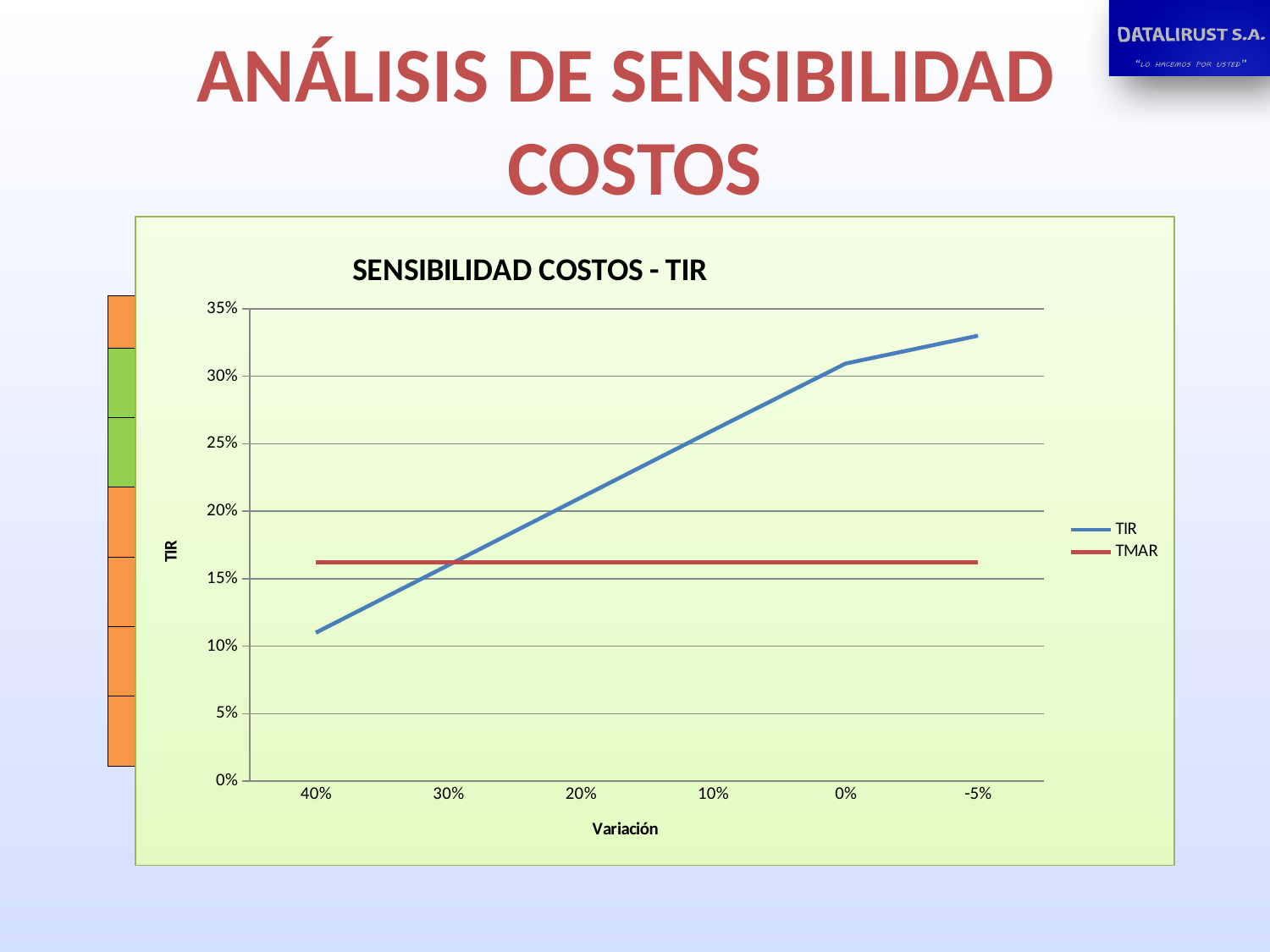
Is the TIR value at Variación 40% greater or less than 15%? less At which Variación value is TIR highest? -5% At which Variación value is TIR lowest? 40% How many categories are shown on the x axis (Variación)? 6 Does the TIR line rise or fall as you move from 40% to -5% along the x axis? rise At Variación 10%, which is larger, TIR or TMAR? TIR How many series does the legend of the chart list? 2 What are the two series named in the legend? TIR and TMAR Is the TIR value at Variación 0% greater or less than 30%? greater What kind of chart is shown on the slide? line chart Is the TMAR value greater or less than 20%? less What is the title of the chart? SENSIBILIDAD COSTOS - TIR